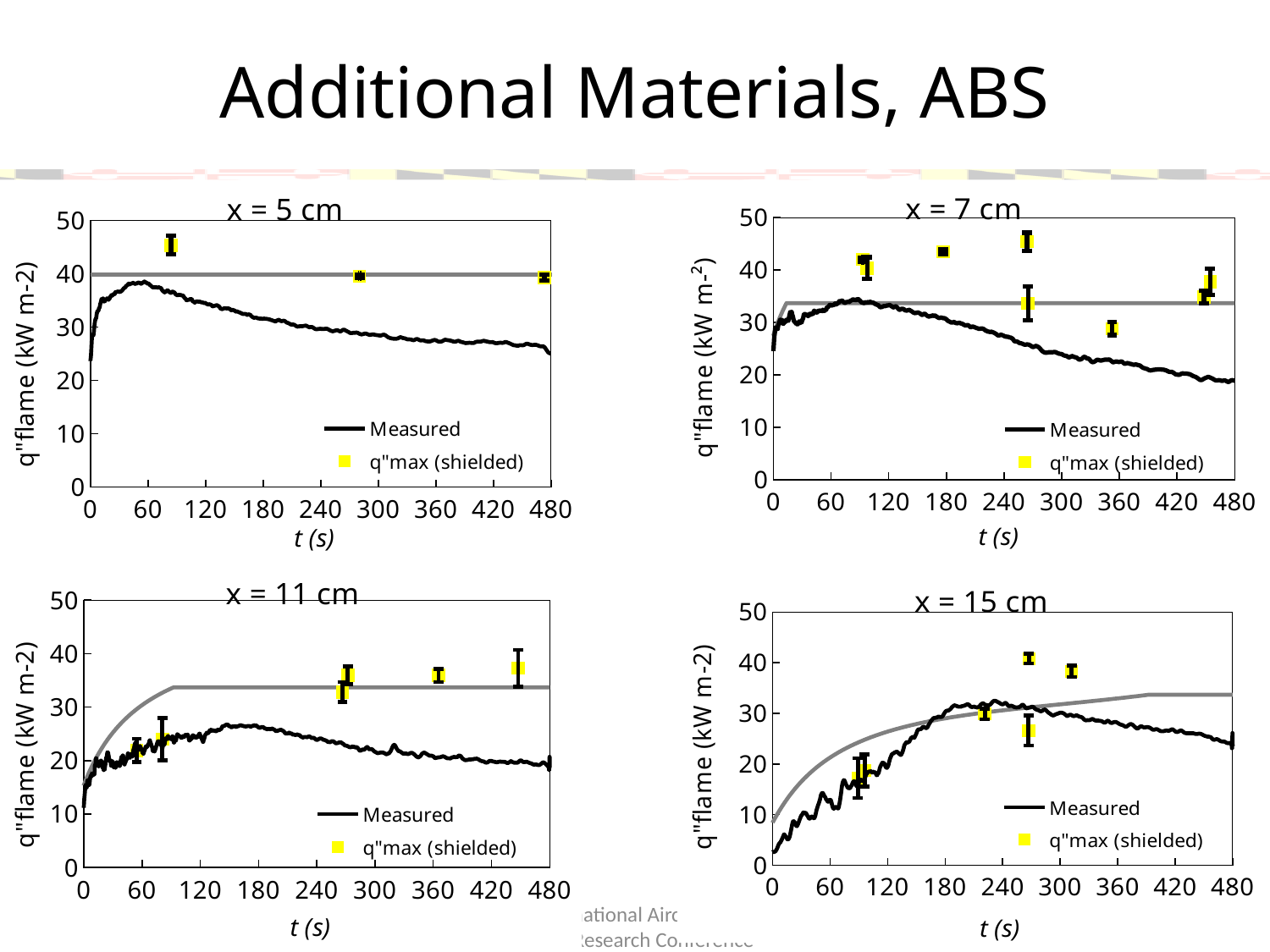
In the x = 7 cm chart, is the Measured value at t = 480 s greater or less than 30? less In the x = 15 cm chart, is the Measured value at t = 0 s greater or less than 10? less In the x = 15 cm chart, does the Measured line rise or fall between t = 0 s and t = 180 s? rise What kind of chart is the x = 5 cm chart? line chart In the x = 5 cm chart, does the Measured line rise or fall between t = 60 s and t = 480 s? fall In the x = 7 cm chart, how many series does the legend list? 2 In the x = 5 cm chart, is the Measured value at t = 60 s greater or less than 30? greater In the x = 5 cm chart, is the Measured value larger at t = 60 s or at t = 480 s? t = 60 s How many charts are shown on the slide? 4 What are the two legend entries in the x = 11 cm chart? Measured and q"max (shielded)